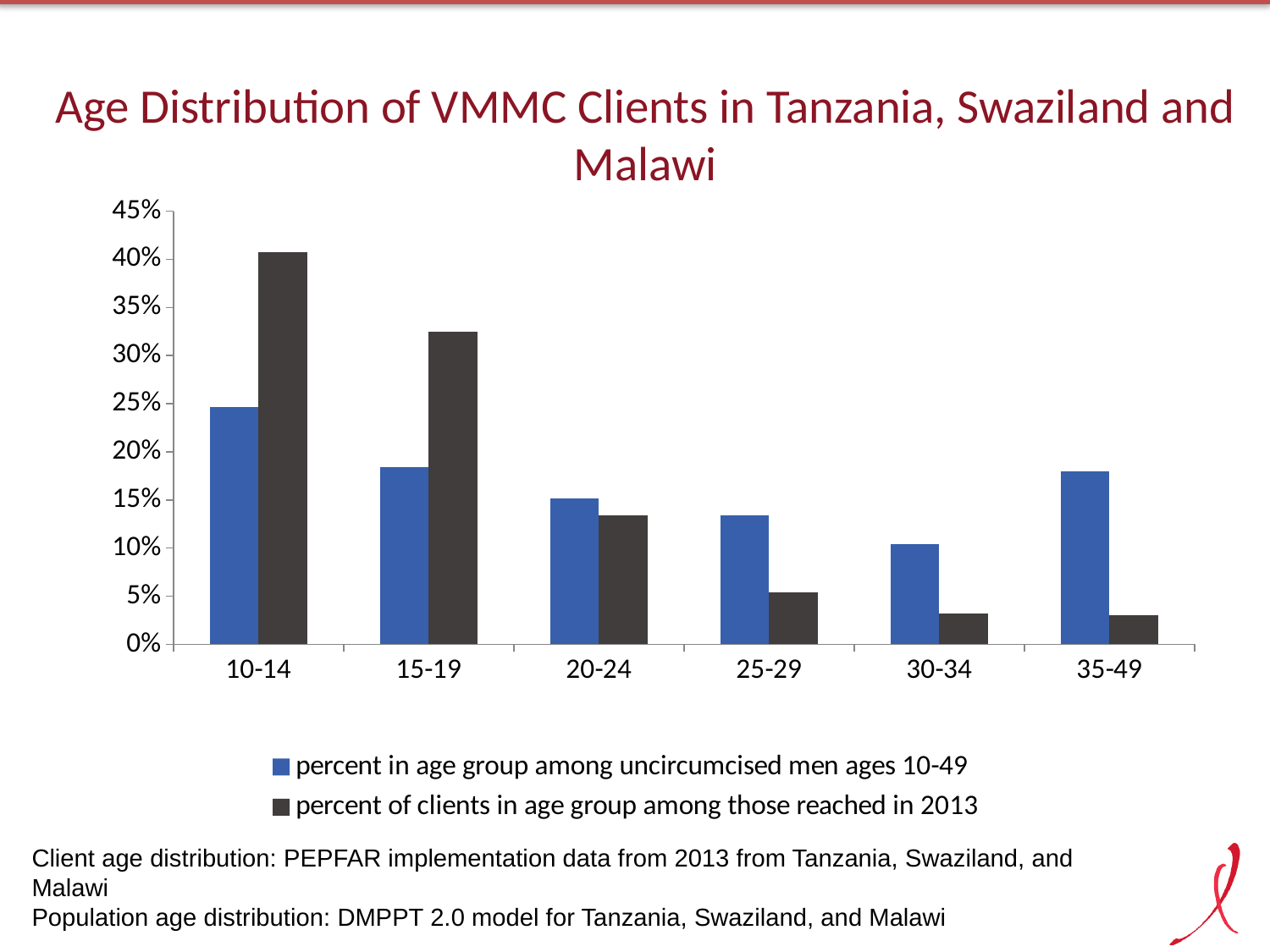
Is the value for 'percent of clients in age group among those reached in 2013' for the 15-19 age group greater or less than 30%? greater Which age group has the highest value for 'percent of clients in age group among those reached in 2013'? 10-14 How many age groups are shown on the x axis? 6 Is the value for 'percent of clients in age group among those reached in 2013' for the 35-49 age group greater or less than 5%? less What kind of chart is shown on the slide? bar chart Do the values for 'percent of clients in age group among those reached in 2013' rise or fall as age group increases along the x axis? fall Is the value for 'percent in age group among uncircumcised men ages 10-49' for the 10-14 age group greater or less than 20%? greater For the 25-29 age group, which series has the larger value: 'percent in age group among uncircumcised men ages 10-49' or 'percent of clients in age group among those reached in 2013'? percent in age group among uncircumcised men ages 10-49 How many series does the legend list? 2 Which age group has the lowest value for 'percent in age group among uncircumcised men ages 10-49'? 30-34 Which age group has the highest value for 'percent in age group among uncircumcised men ages 10-49'? 10-14